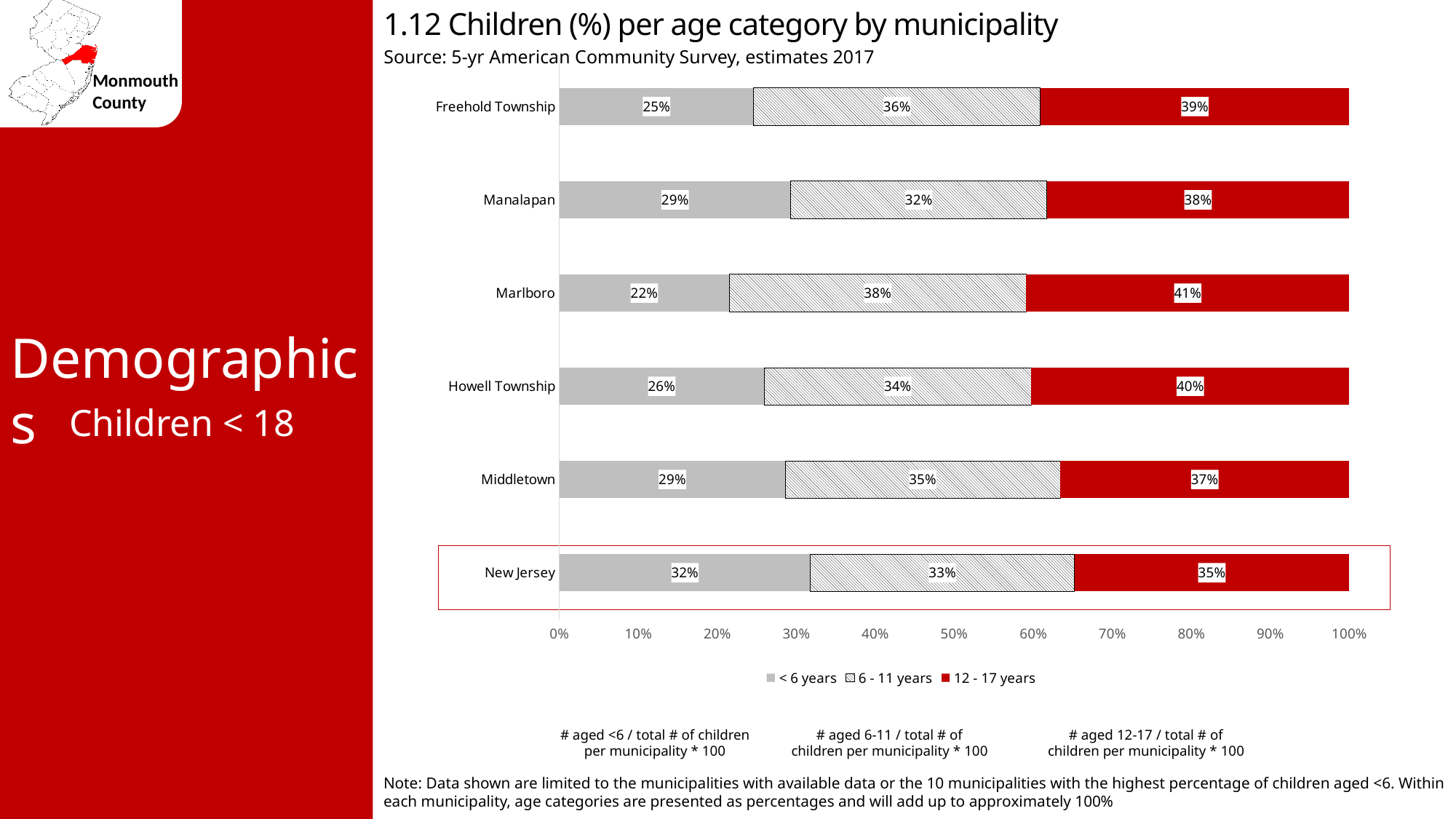
What kind of chart is shown on the slide? Stacked bar chart What percentage of children in Howell Township are aged 6 - 11 years? 34% Which has a larger < 6 years share, Middletown or Howell Township? Middletown Which category has the lowest percentage of children aged < 6 years? Marlboro What is the value for the < 6 years series for New Jersey? 32% What percentage of children in Marlboro are aged 12 - 17 years? 41% What is the total of the three segments for the Freehold Township bar? 100% Which municipality has the highest percentage of children aged 12 - 17 years? Marlboro Which category has the highest percentage of children aged < 6 years? New Jersey For Freehold Township, how many percentage points higher is the 12 - 17 years share than the < 6 years share? 14 percentage points How many municipalities/categories are shown on the chart? 6 How many series does the legend list? 3